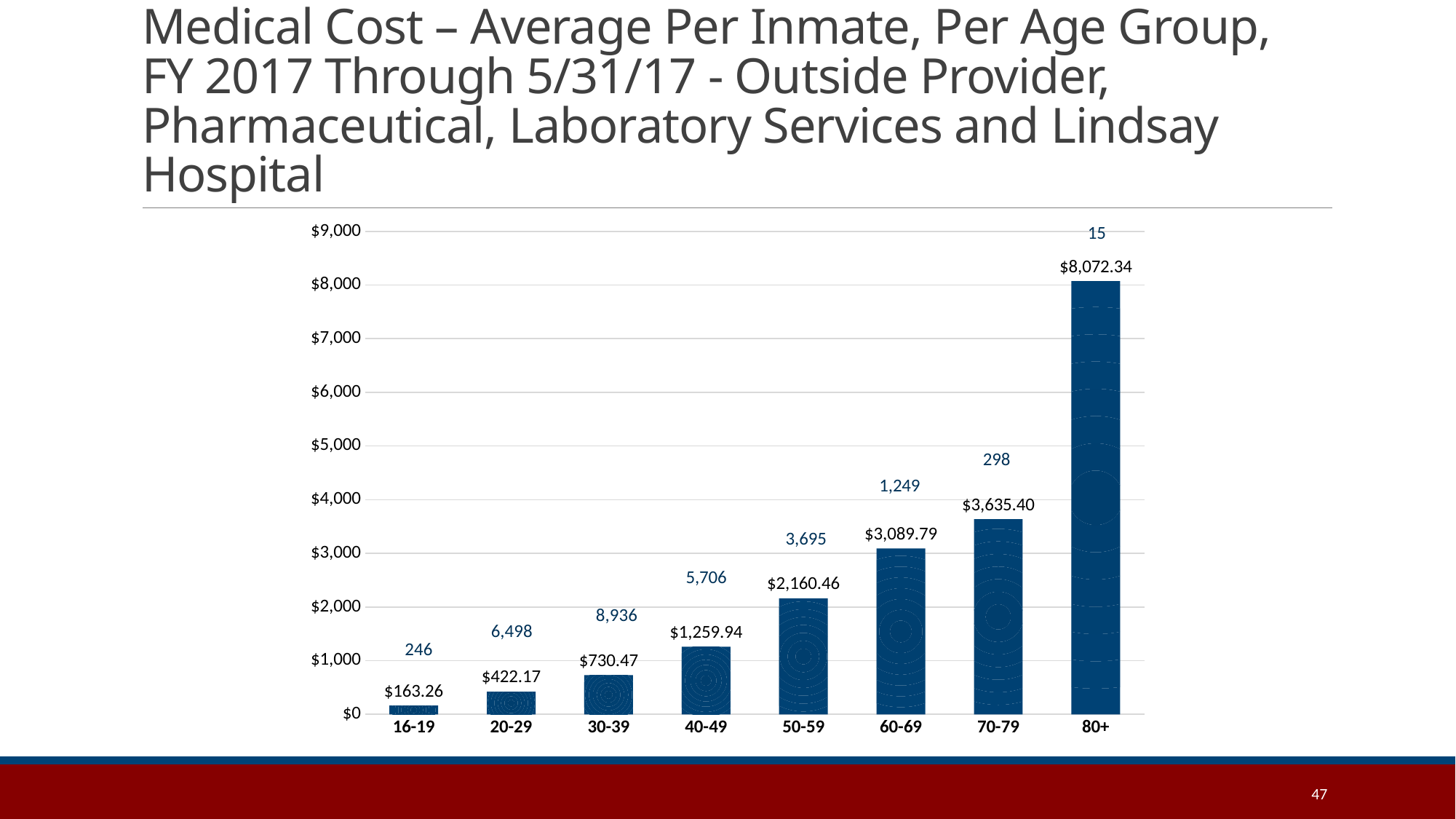
Which age group has the highest average medical cost per inmate? 80+ Is the average medical cost per inmate for the 40-49 age group greater or less than $1,000? greater What is the difference in average medical cost per inmate between the 80+ and 70-79 age groups? $4,436.94 Do the average medical costs per inmate rise or fall as the age groups increase along the x axis? rise Which age group has a higher average medical cost per inmate, 30-39 or 50-59? 50-59 What is the average medical cost per inmate for the 40-49 age group? $1,259.94 Which age group has the lowest average medical cost per inmate? 16-19 What is the average medical cost per inmate for the 20-29 age group? $422.17 What kind of chart is shown on the slide? bar chart What is the average medical cost per inmate for the 80+ age group? $8,072.34 How many age groups are shown on the chart? 8 What is the difference in average medical cost per inmate between the 60-69 and 50-59 age groups? $929.33